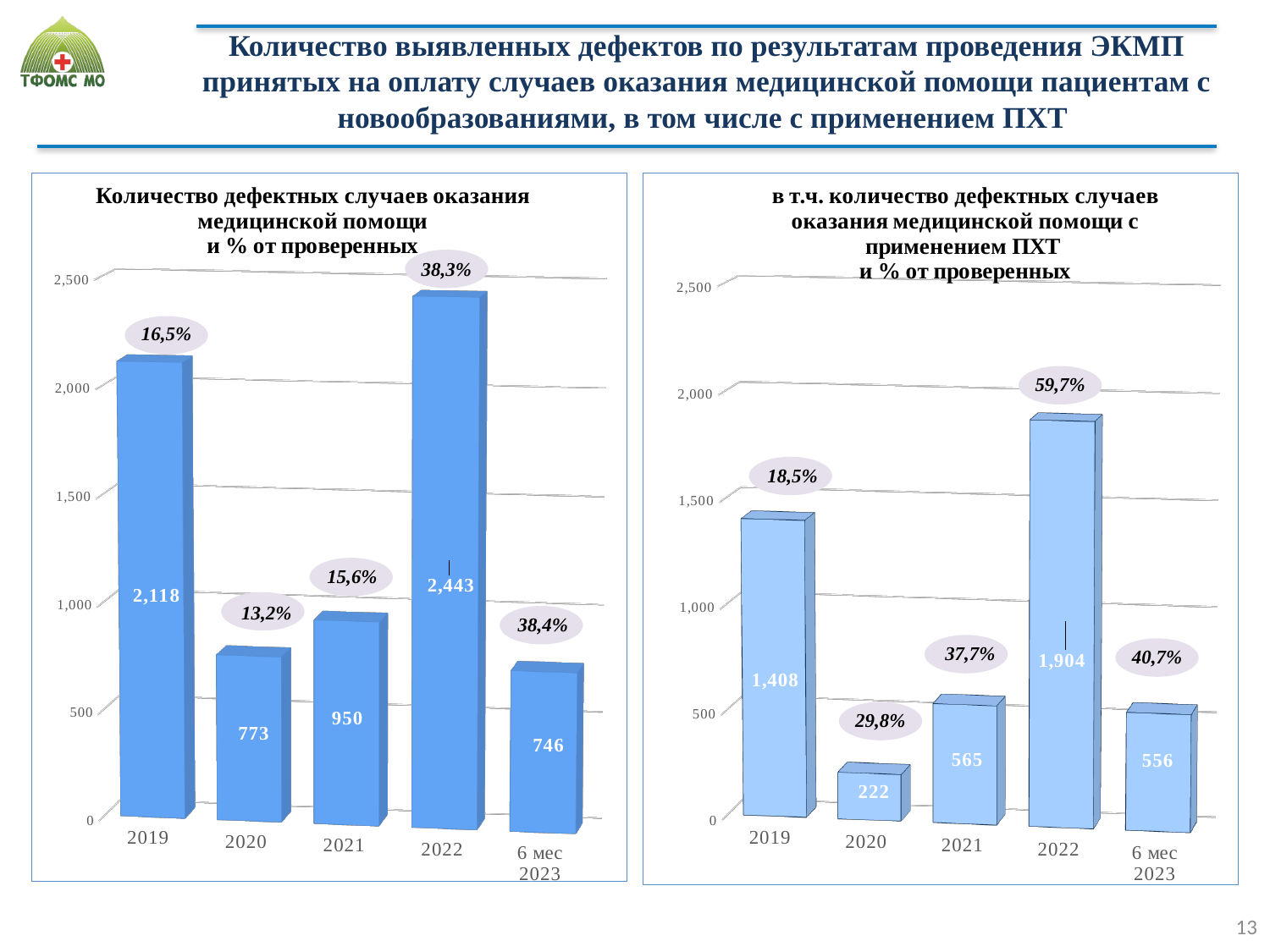
How many categories are shown on the x axis of the left chart? 5 In the right chart, what percentage label is shown above the 2022 bar? 59,7% In the left chart, which category has the lowest value? 6 мес 2023 In the right chart, what is the value for 2020? 222 In the right chart, what is the difference between the values for 2019 and 2022? 496 In the right chart, which year has the lowest value? 2020 In the left chart, what percentage label is shown above the 2022 bar? 38,3% What type of chart is the right chart? Bar chart In the left chart, what is the value for 2019? 2,118 In the right chart, which is larger, the value for 2021 or the value for 6 мес 2023? 2021 In the left chart, which year has the highest value? 2022 In the left chart, what is the difference between the values for 2022 and 2019? 325